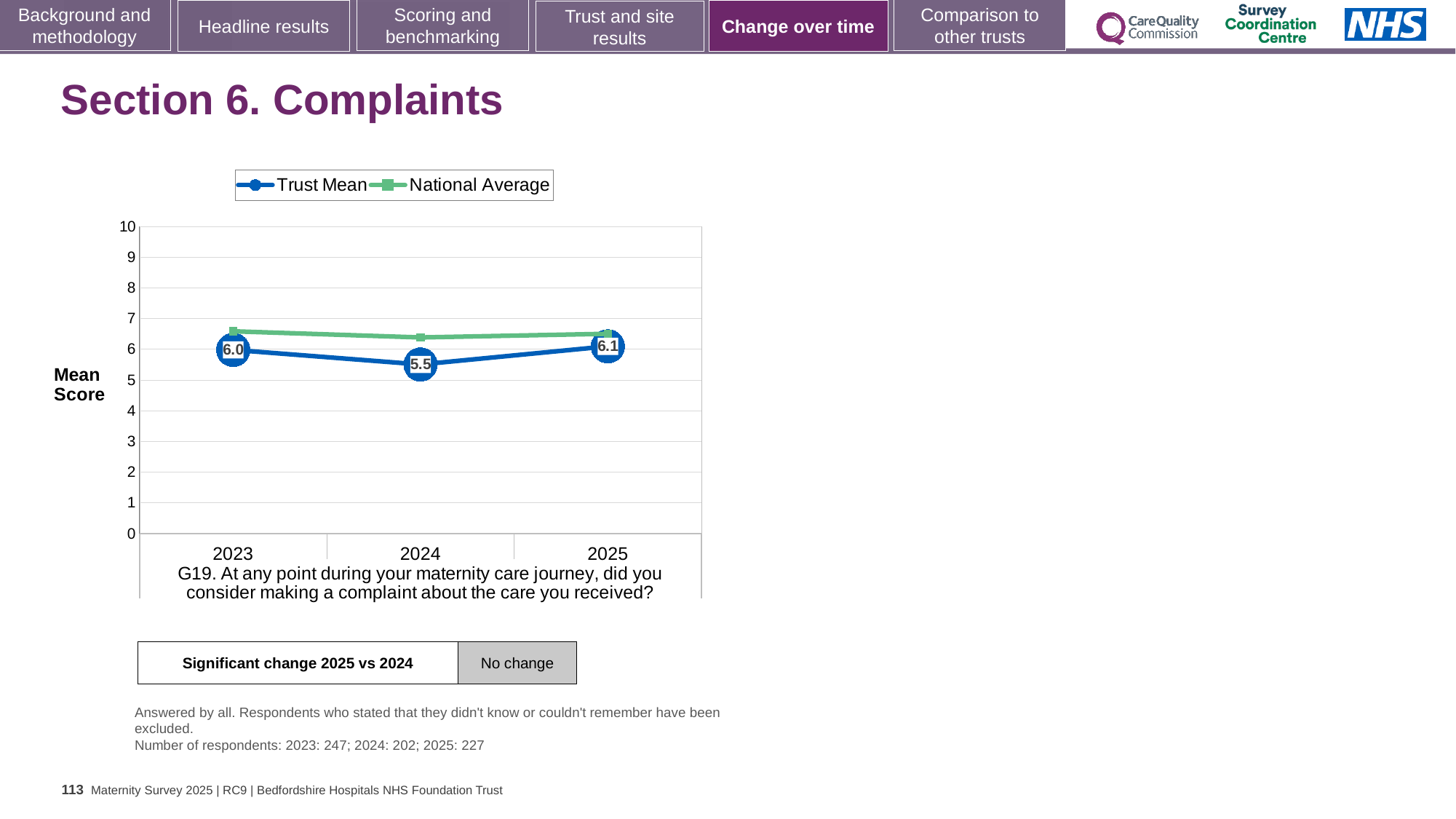
Is the National Average for 2024 greater or less than 7? less Is the National Average for 2023 greater or less than 6? greater Which is larger, the Trust Mean score for 2023 or for 2024? 2023 In which year is the Trust Mean score highest? 2025 What is the Trust Mean score for 2023? 6.0 How many series does the chart legend list? 2 What is the Trust Mean score for 2024? 5.5 In which year is the Trust Mean score lowest? 2024 What kind of chart is shown on the slide? line chart How many years are shown on the x axis of the chart? 3 What is the Trust Mean score for 2025? 6.1 What is the difference between the Trust Mean scores for 2025 and 2024? 0.6